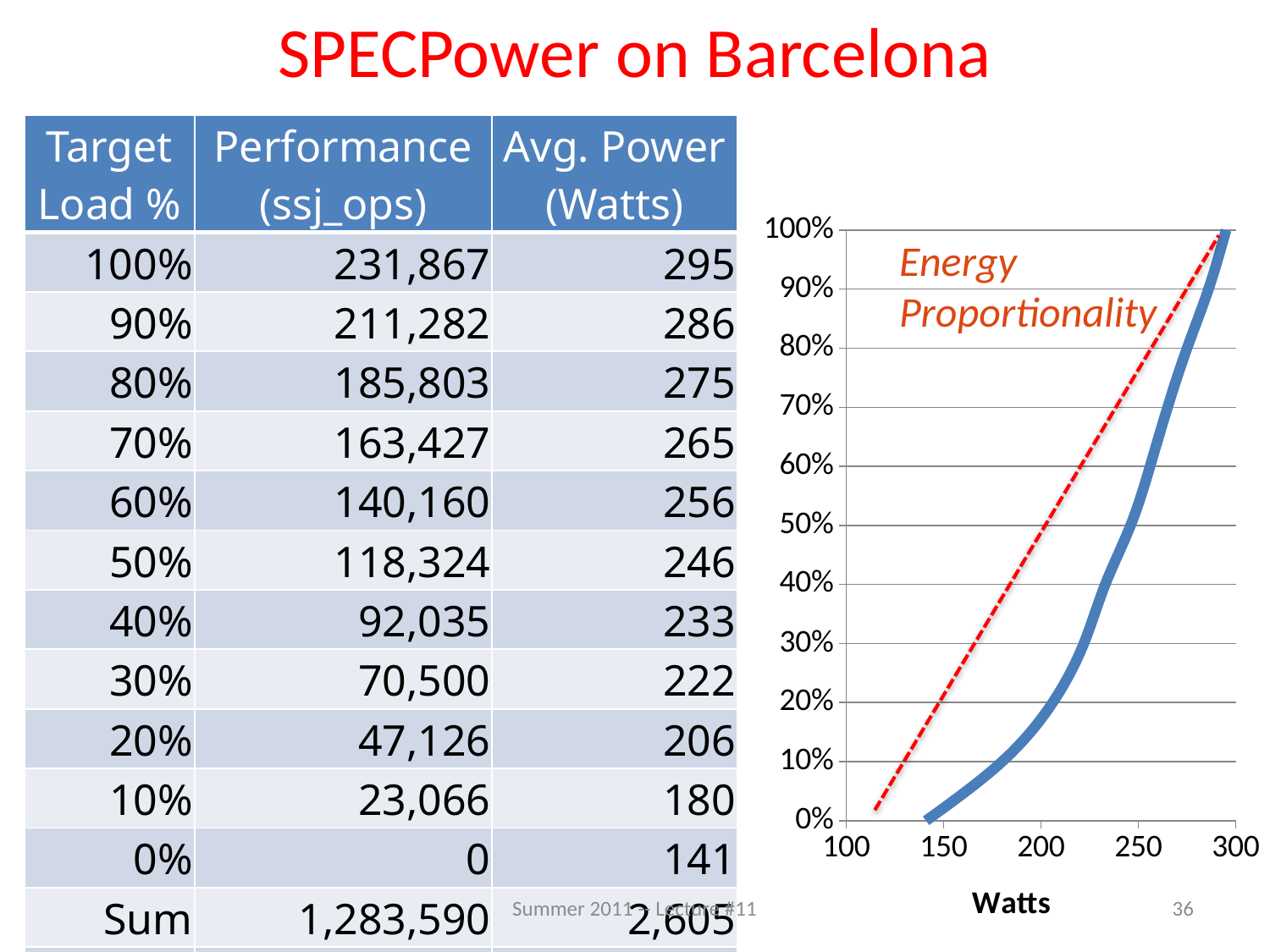
On the chart, is the power at 0% load greater or less than 150 watts? less On the chart, is the power at 50% load greater or less than 200 watts? greater On the chart, is the power at 100% load greater or less than 300 watts? less According to the slide, what is the average power in watts at 0% target load? 141 What label is written next to the red dashed line on the chart? Energy Proportionality What is the title of the x axis of the chart? Watts How many target load levels are plotted on the chart, from 0% to 100%? 11 What kind of chart is shown on the right of the slide? line chart On the chart, does the load percentage rise or fall as the watts increase along the x axis? rise According to the slide, what is the difference in average power between 100% load and 0% load? 154 According to the slide, what is the average power in watts at 100% target load? 295